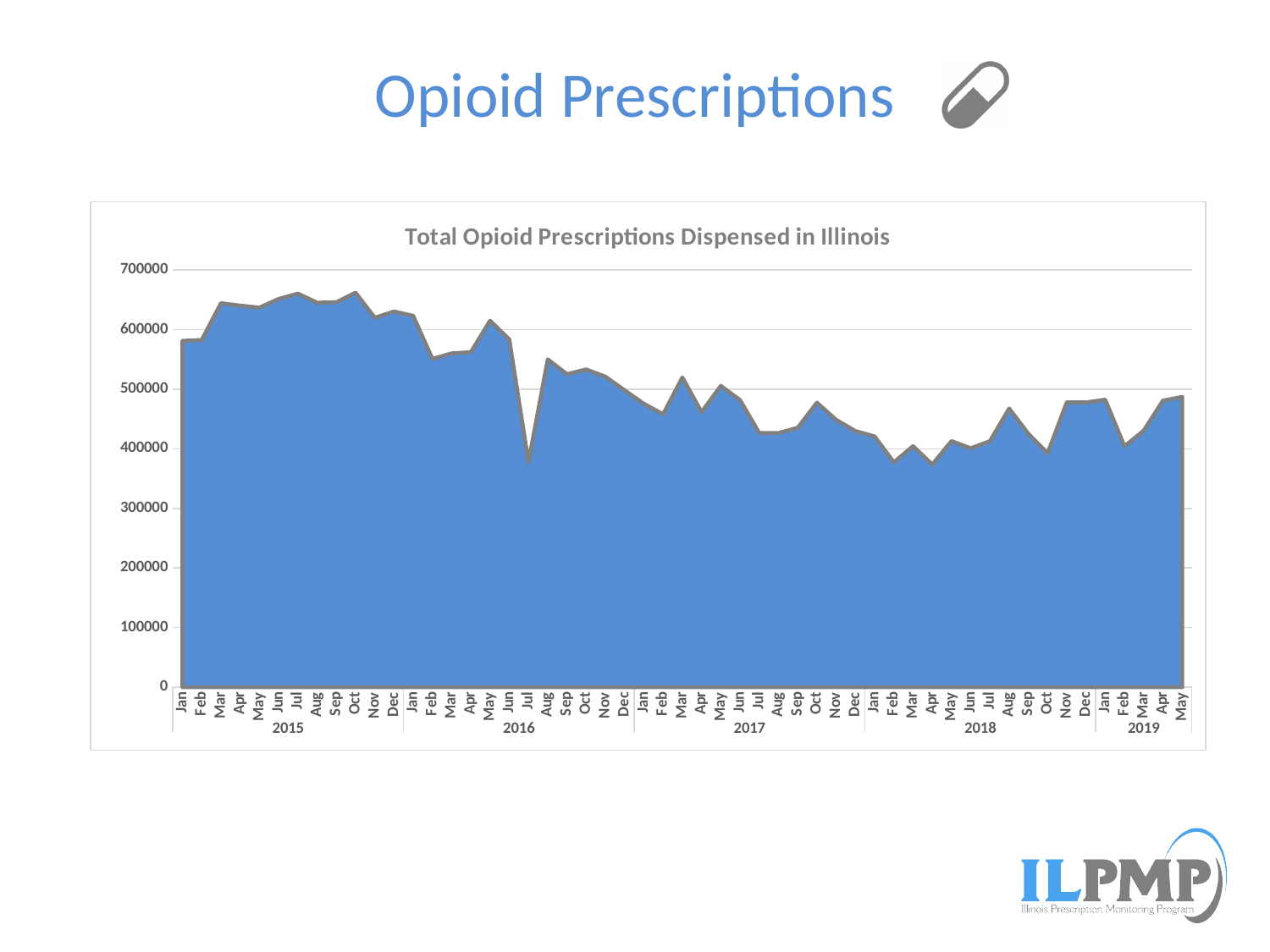
What kind of chart is shown on the slide? area chart Is the value for Jul 2016 greater or less than 400000? less Is the value for May 2019 greater or less than 500000? less Which is larger, the value for Jul 2015 or the value for Jul 2016? Jul 2015 What is the title of the chart? Total Opioid Prescriptions Dispensed in Illinois How many monthly data points are plotted in the chart, from Jan 2015 to May 2019? 53 Is the value for Jul 2015 greater or less than 600000? greater Overall, do the values in the chart rise or fall from 2015 to 2019? fall Which is larger, the value for Jan 2015 or the value for Jan 2019? Jan 2015 Which years are labelled along the x axis of the chart? 2015, 2016, 2017, 2018, 2019